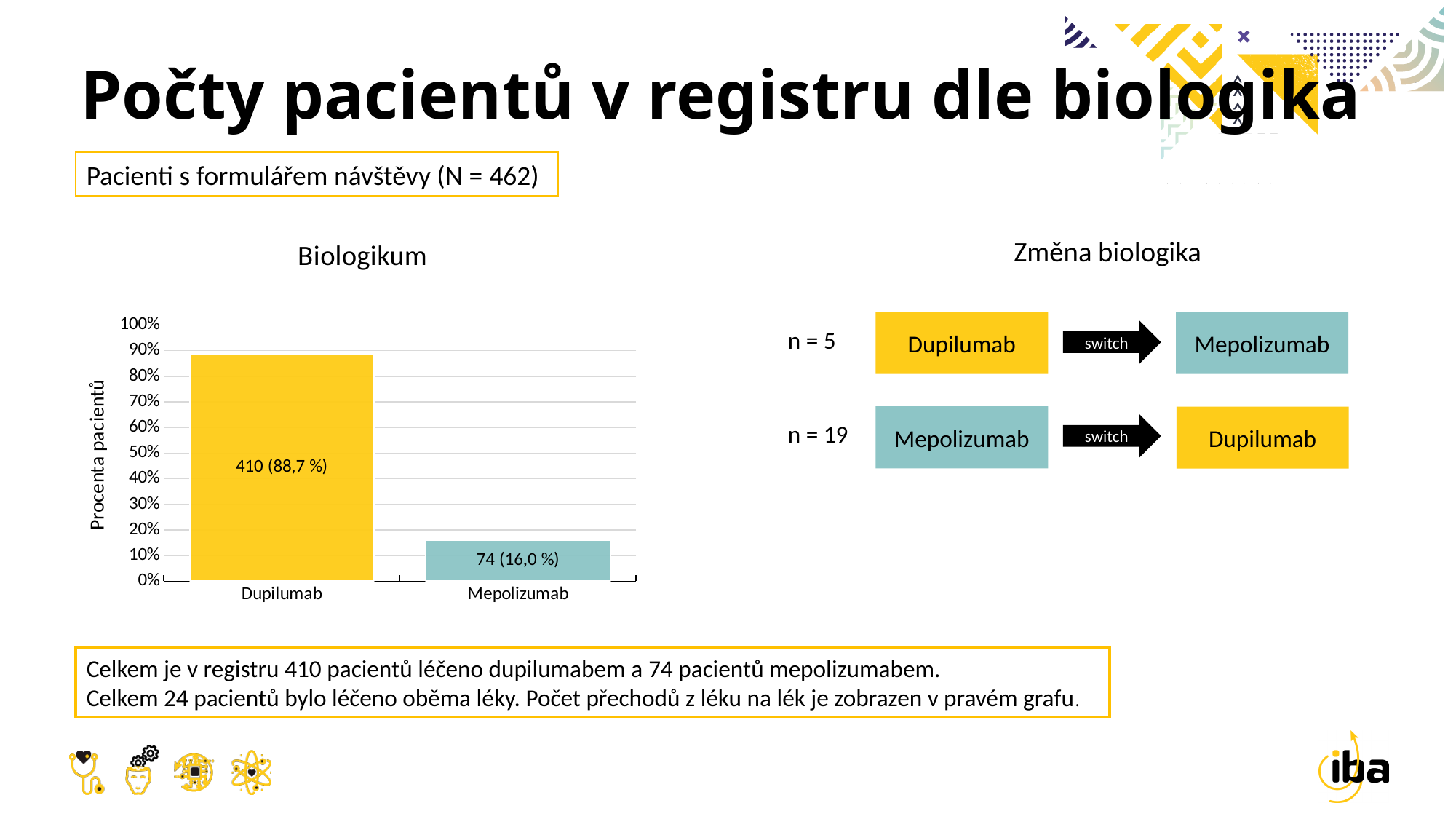
What kind of chart is the Biologikum chart? bar chart In the Biologikum chart, is the value for Mepolizumab greater or less than 20%? less In the Biologikum chart, how many more patients are on Dupilumab than on Mepolizumab? 336 How many categories are shown on the x axis of the Biologikum chart? 2 Which category has the highest bar in the Biologikum chart? Dupilumab In the Biologikum chart, is the bar for Dupilumab or Mepolizumab larger? Dupilumab In the Biologikum chart, how many patients are shown for Dupilumab? 410 What is the data label on the Dupilumab bar in the Biologikum chart? 410 (88,7 %) Which category has the lowest bar in the Biologikum chart? Mepolizumab What is the data label on the Mepolizumab bar in the Biologikum chart? 74 (16,0 %) What is the y-axis label of the Biologikum chart? Procenta pacientů In the Biologikum chart, what percentage of patients is shown for Mepolizumab? 16,0 %